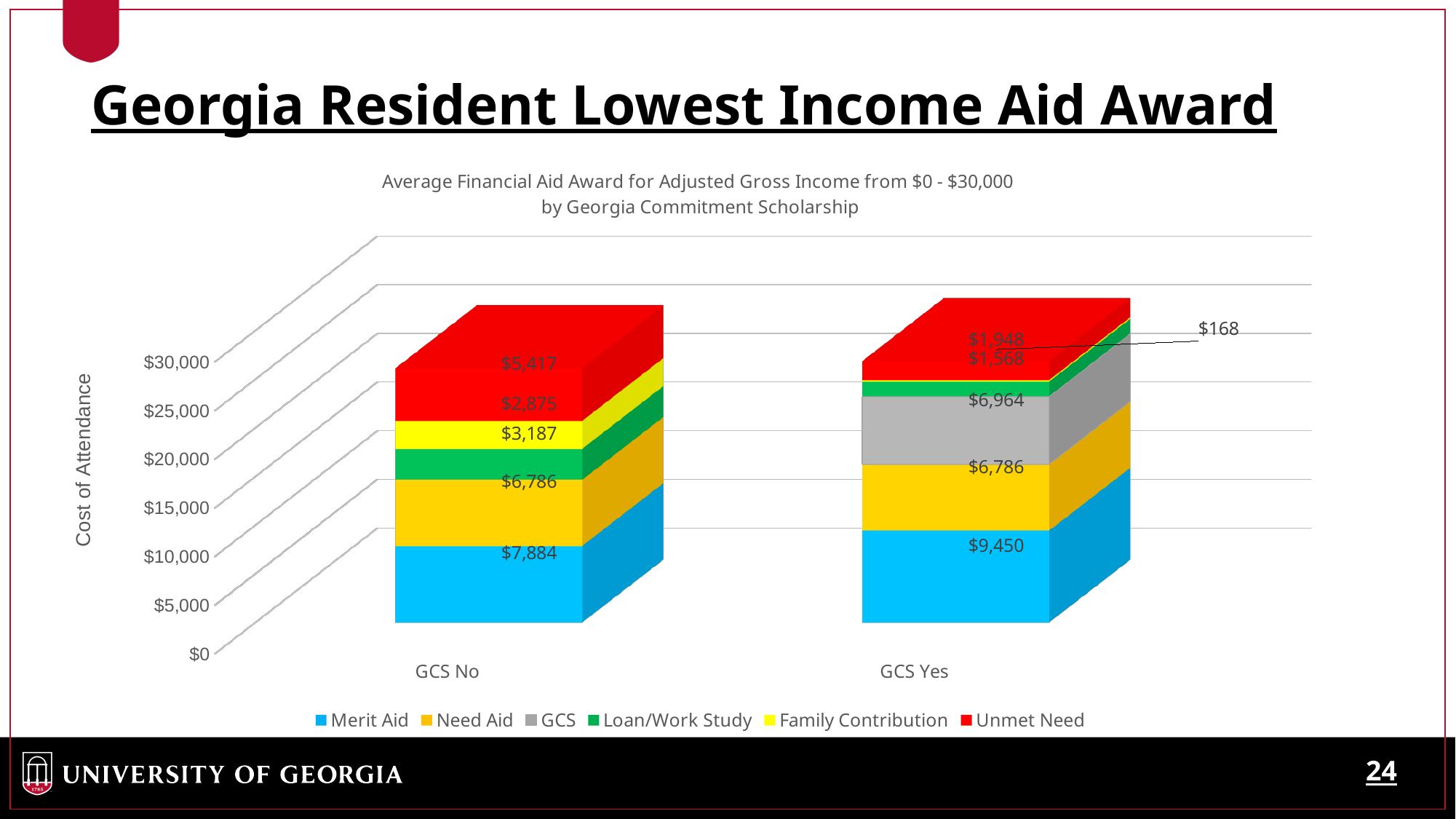
What kind of chart is shown on the slide? Stacked bar chart What is the GCS value for the GCS Yes bar? $6,964 How much larger is Merit Aid for GCS Yes than for GCS No? $1,566 What is the difference in Unmet Need between GCS No and GCS Yes? $3,469 How many categories are shown on the x axis? 2 What is the Merit Aid value for GCS Yes? $9,450 What is the Merit Aid value for GCS No? $7,884 What is the Loan/Work Study value for GCS No? $3,187 Which category has the larger Unmet Need, GCS No or GCS Yes? GCS No How many series does the legend list? 6 What is the Family Contribution value for GCS Yes? $168 What is the Unmet Need value for GCS No? $5,417